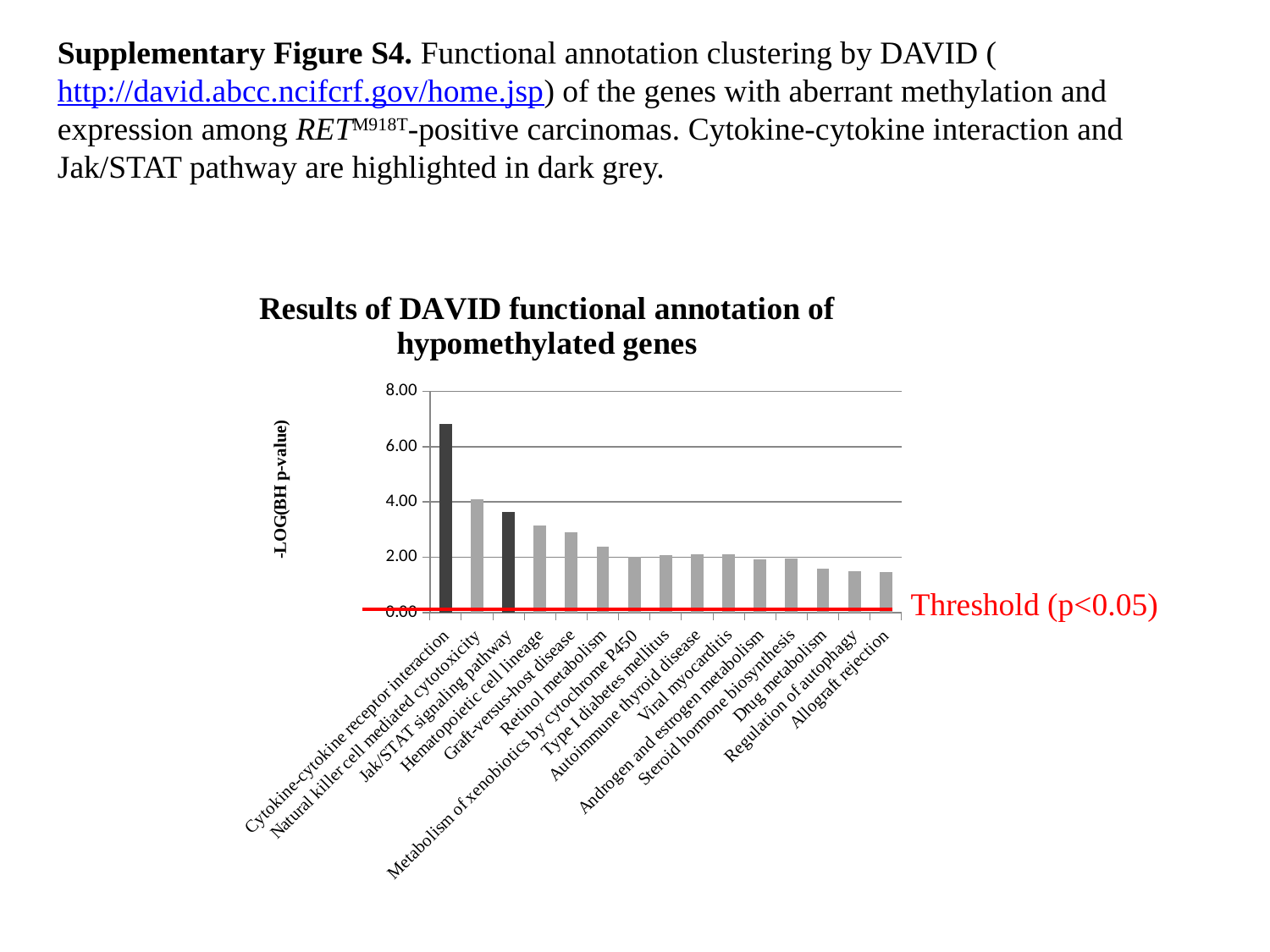
Is the value for Allograft rejection greater or less than 2.00? less What kind of chart is shown on the slide? bar chart What is the label on the vertical axis of the chart? -LOG(BH p-value) Is the value for Hematopoietic cell lineage greater or less than 2.00? greater Which is larger, the value for Retinol metabolism or the value for Drug metabolism? Retinol metabolism Is the value for Cytokine-cytokine receptor interaction greater or less than 6.00? greater Which is larger, the value for Cytokine-cytokine receptor interaction or the value for Natural killer cell mediated cytotoxicity? Cytokine-cytokine receptor interaction What is the title of the chart? Results of DAVID functional annotation of hypomethylated genes Which category has the highest bar in the chart? Cytokine-cytokine receptor interaction How many categories (bars) are plotted in the chart? 15 Do the bar values generally rise or fall from left to right along the x axis? fall